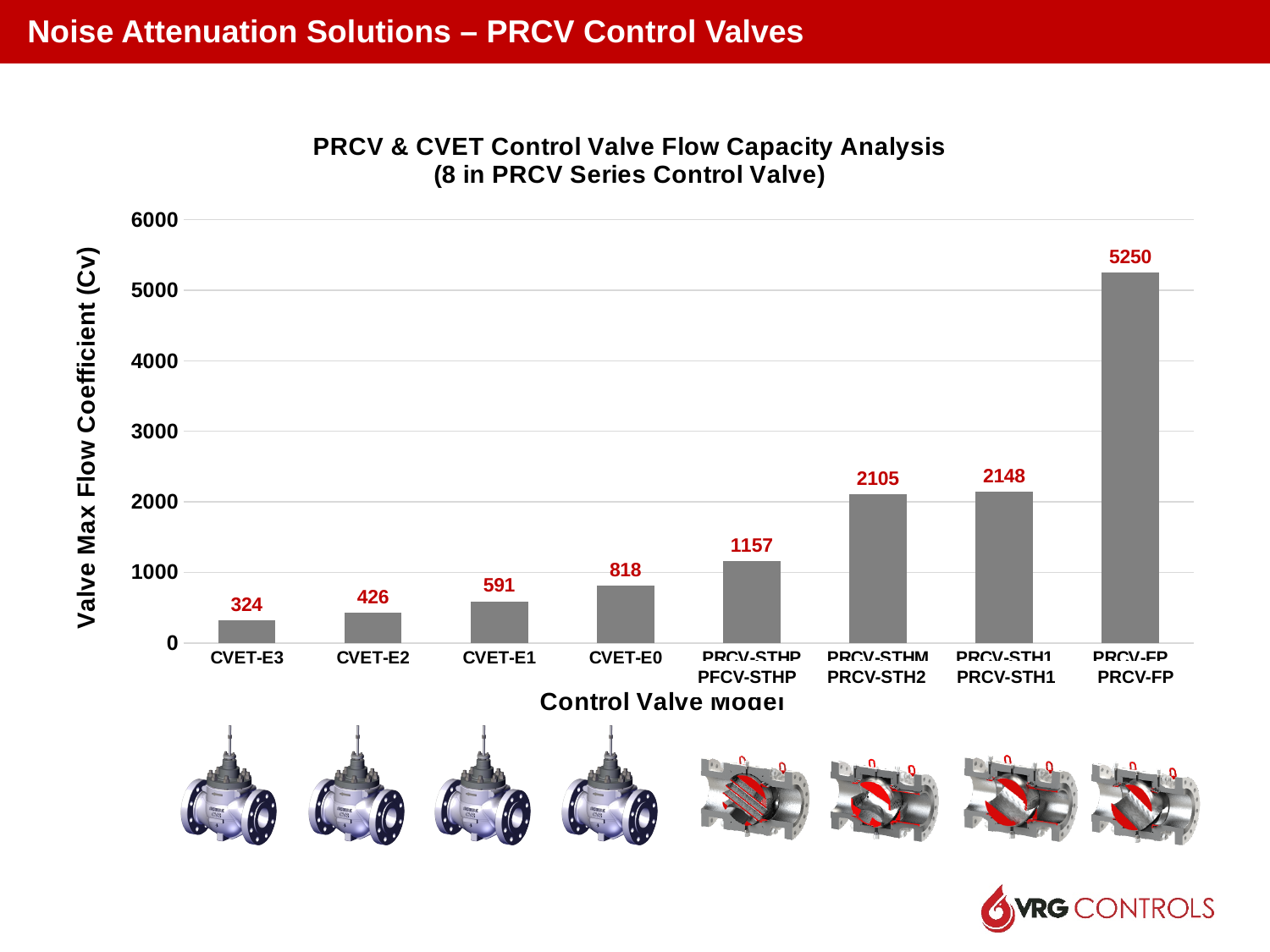
What is the Valve Max Flow Coefficient (Cv) for PRCV-FP? 5250 What is the difference between the Cv values for CVET-E1 and CVET-E2? 165 Is the Cv value for PRCV-STH1 greater or less than 2000? greater Which has a larger Cv value, CVET-E0 or CVET-E1? CVET-E0 What kind of chart is shown on the slide? bar chart Which control valve model has the lowest Valve Max Flow Coefficient (Cv)? CVET-E3 What is the title of the vertical axis of the chart? Valve Max Flow Coefficient (Cv) How much larger is the Cv value for PRCV-FP than for PRCV-STH1? 3102 What is the Valve Max Flow Coefficient (Cv) for CVET-E0? 818 What is the Valve Max Flow Coefficient (Cv) for CVET-E3? 324 Which control valve model has the highest Valve Max Flow Coefficient (Cv)? PRCV-FP How many control valve models are plotted on the chart? 8